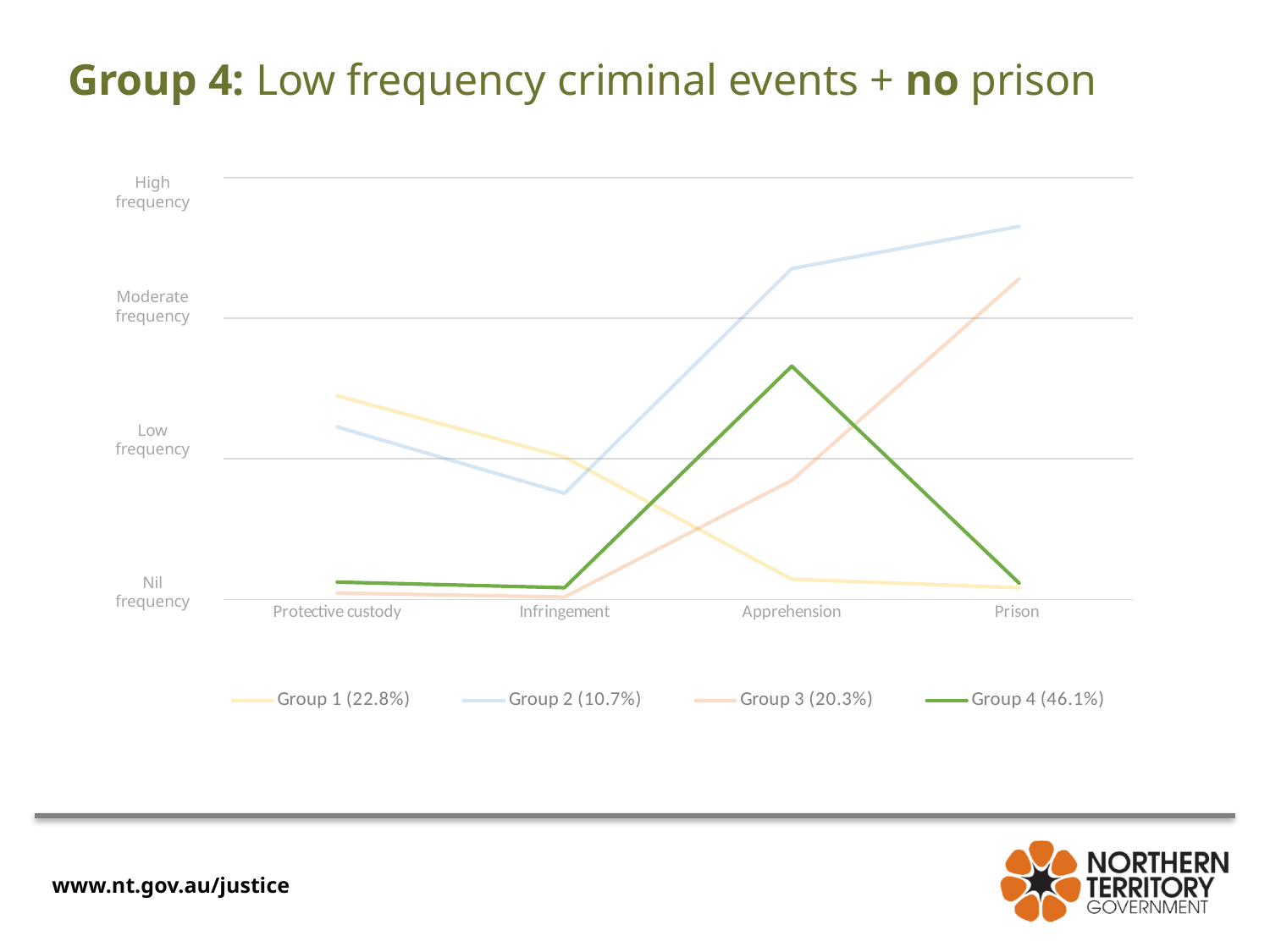
At which category does the Group 1 (22.8%) line reach its highest point? Protective custody How many series does the legend list? 4 Which series has the lowest value at Apprehension? Group 1 (22.8%) Does the Group 3 (20.3%) line rise or fall from Infringement to Prison? Rise At which category does the Group 4 (46.1%) line reach its highest point? Apprehension How many categories are shown on the x axis? 4 What kind of chart is shown on the slide? Line chart What percentage is shown in the legend for Group 4? 46.1% At Apprehension, which is higher: Group 4 (46.1%) or Group 3 (20.3%)? Group 4 (46.1%) Which series has the highest value at Prison? Group 2 (10.7%) Is the value for Group 2 (10.7%) at Apprehension above or below Moderate frequency? Above